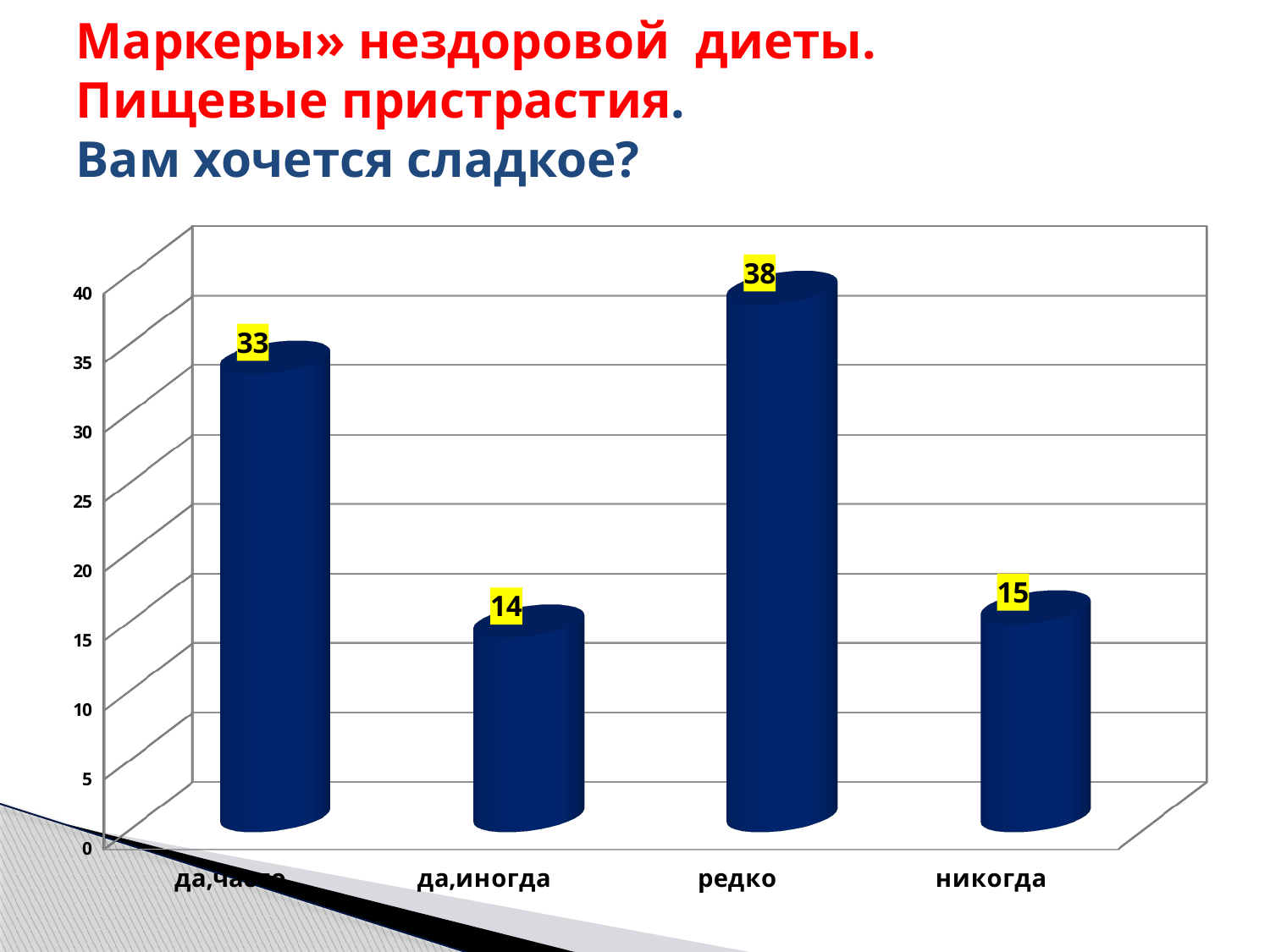
What kind of chart is shown on the slide? bar chart What is the value for the category "да,иногда"? 14 Which category has the highest value? редко What is the value for the category "никогда"? 15 How many categories are shown on the x axis of the chart? 4 Is the value for "редко" greater or less than 35? greater Which category has the lowest value? да,иногда What is the difference between the values for "редко" and the leftmost bar? 5 What is the value shown on the leftmost bar of the chart? 33 What is the value for the category "редко"? 38 Which is larger, the value for "никогда" or the value for "да,иногда"? никогда What is the difference between the values for "редко" and "да,иногда"? 24